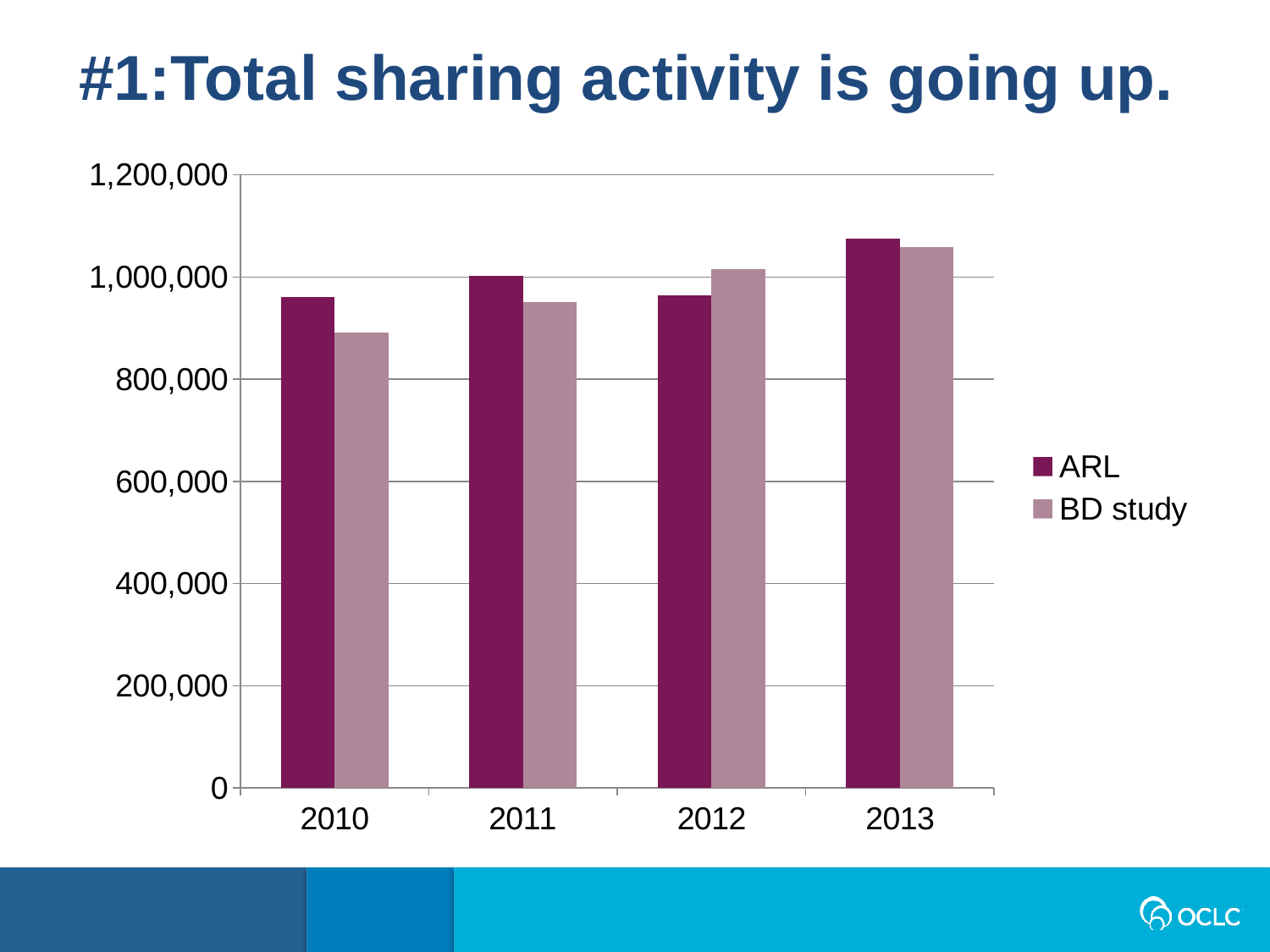
Which year has the highest BD study value? 2013 What kind of chart is shown on the slide? bar chart Is the BD study value for 2010 greater or less than 1,000,000? less What is the title of the slide containing the chart? #1:Total sharing activity is going up. Which year has the lowest BD study value? 2010 In 2010, which is larger, the ARL value or the BD study value? ARL Which year has the highest ARL value? 2013 How many years are shown on the x axis? 4 How many series does the legend list? 2 Do the BD study values rise or fall from 2010 to 2013? rise In 2012, which is larger, the ARL value or the BD study value? BD study Is the ARL value for 2013 greater or less than 1,000,000? greater